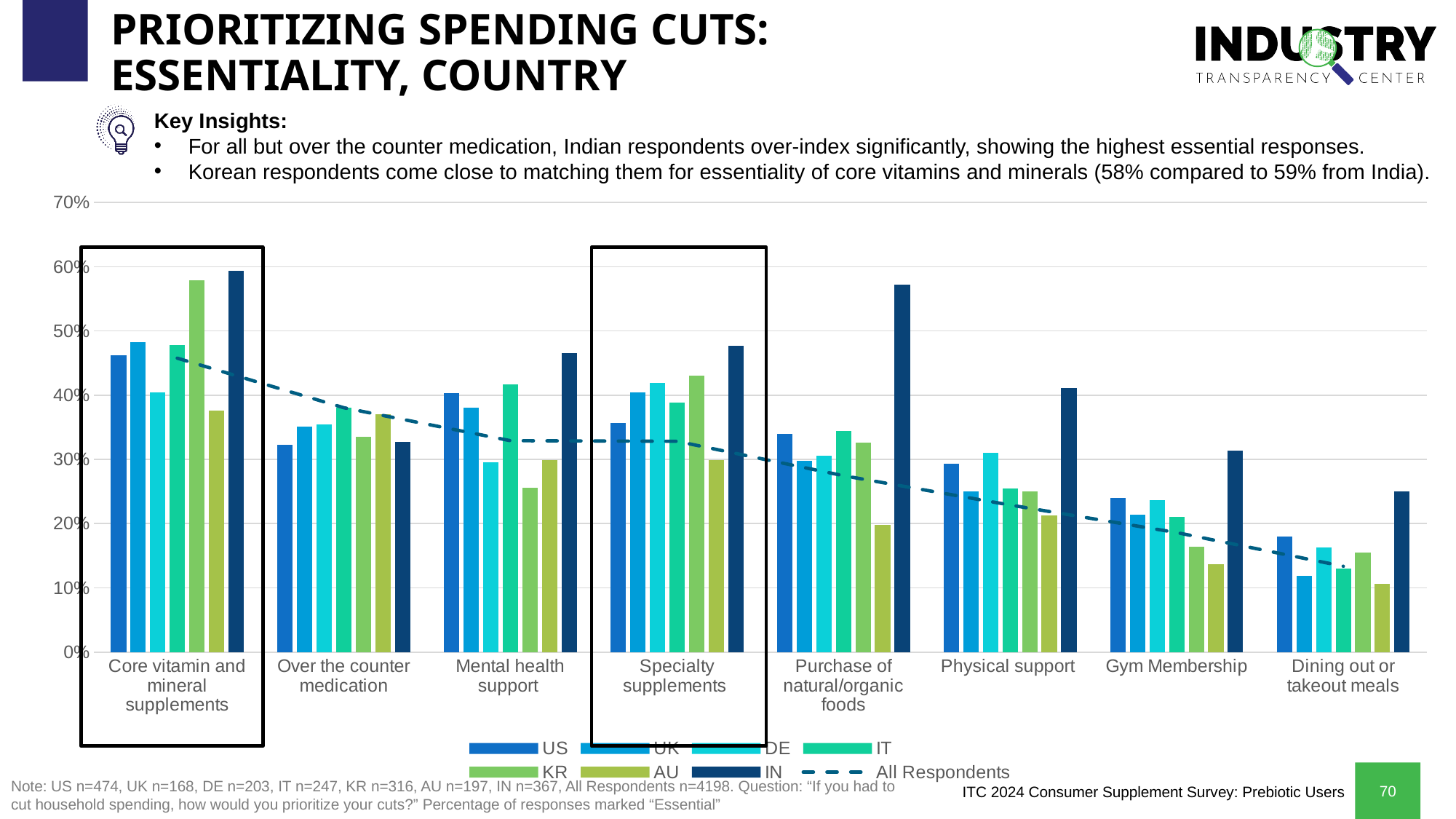
How many spending categories are shown along the x axis? 8 Is the value for IN in Purchase of natural/organic foods greater or less than 50%? greater Does the dashed All Respondents line rise or fall from left to right across the categories? fall Is the value for UK in Dining out or takeout meals greater or less than 20%? less Which country has the lowest essential response for Mental health support? KR How many series does the legend list? 8 Which country has the highest essential response for Purchase of natural/organic foods? IN Which two categories are outlined with black boxes on the chart? Core vitamin and mineral supplements; Specialty supplements For Specialty supplements, which is larger, the value for KR or the value for AU? KR For Gym Membership, which is larger, the value for US or the value for IN? IN Is the value for KR in Core vitamin and mineral supplements greater or less than 50%? greater What kind of chart is shown on the slide? combination bar and line chart